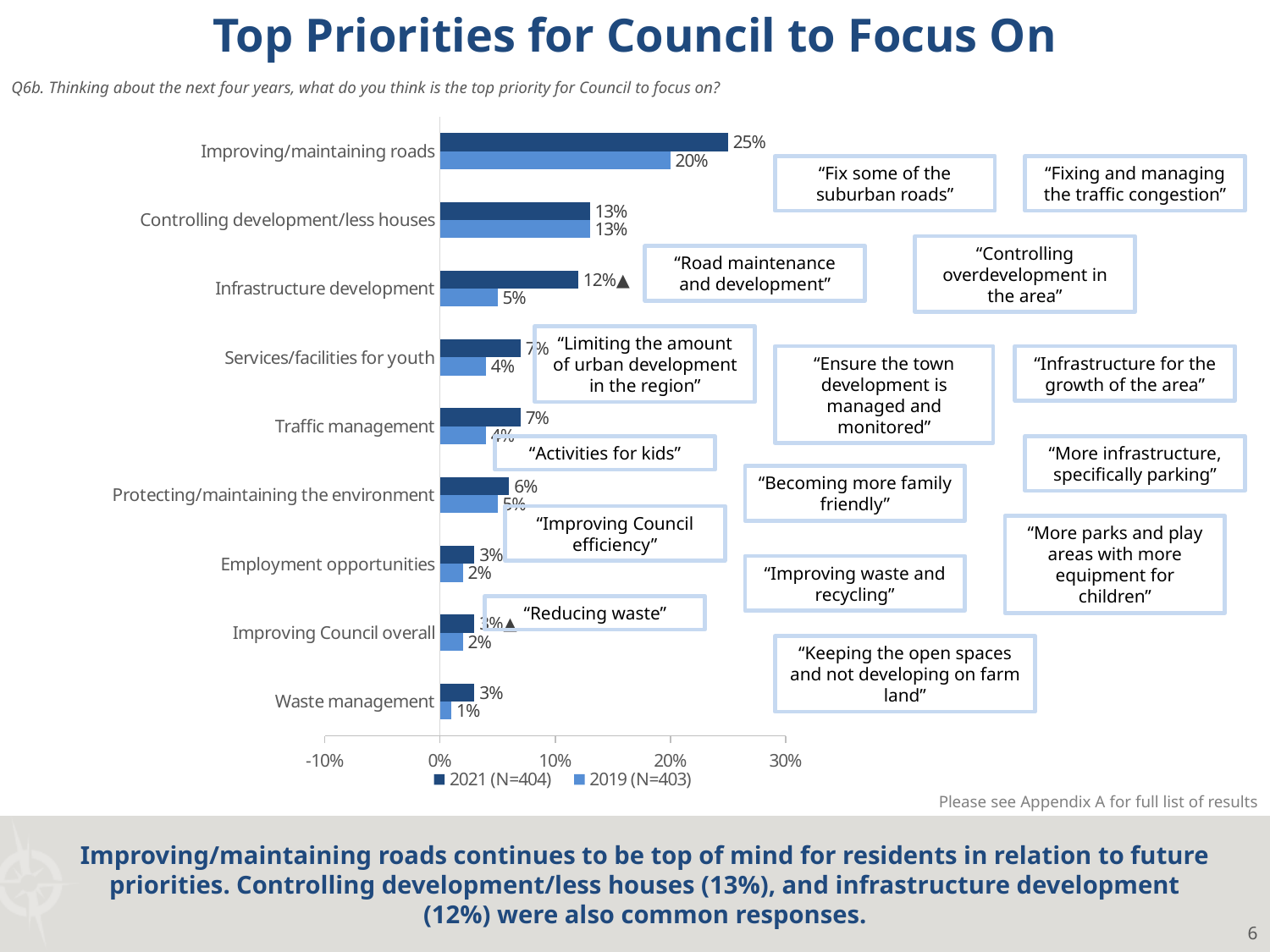
What is the 2019 value for Waste management? 1% How many priority categories are plotted on the chart? 9 What is the difference between the 2021 and 2019 values for Improving/maintaining roads? 5% Which is larger for Infrastructure development, the 2021 value or the 2019 value? 2021 What kind of chart is shown on the slide? bar chart How many series does the legend list? 2 What is the 2019 value for Infrastructure development? 5% Which category has the lowest 2019 value? Waste management What is the 2021 value for Infrastructure development? 12% What is the 2019 value for Improving/maintaining roads? 20% What is the 2021 value for Improving/maintaining roads? 25% Which category has the highest 2021 value? Improving/maintaining roads